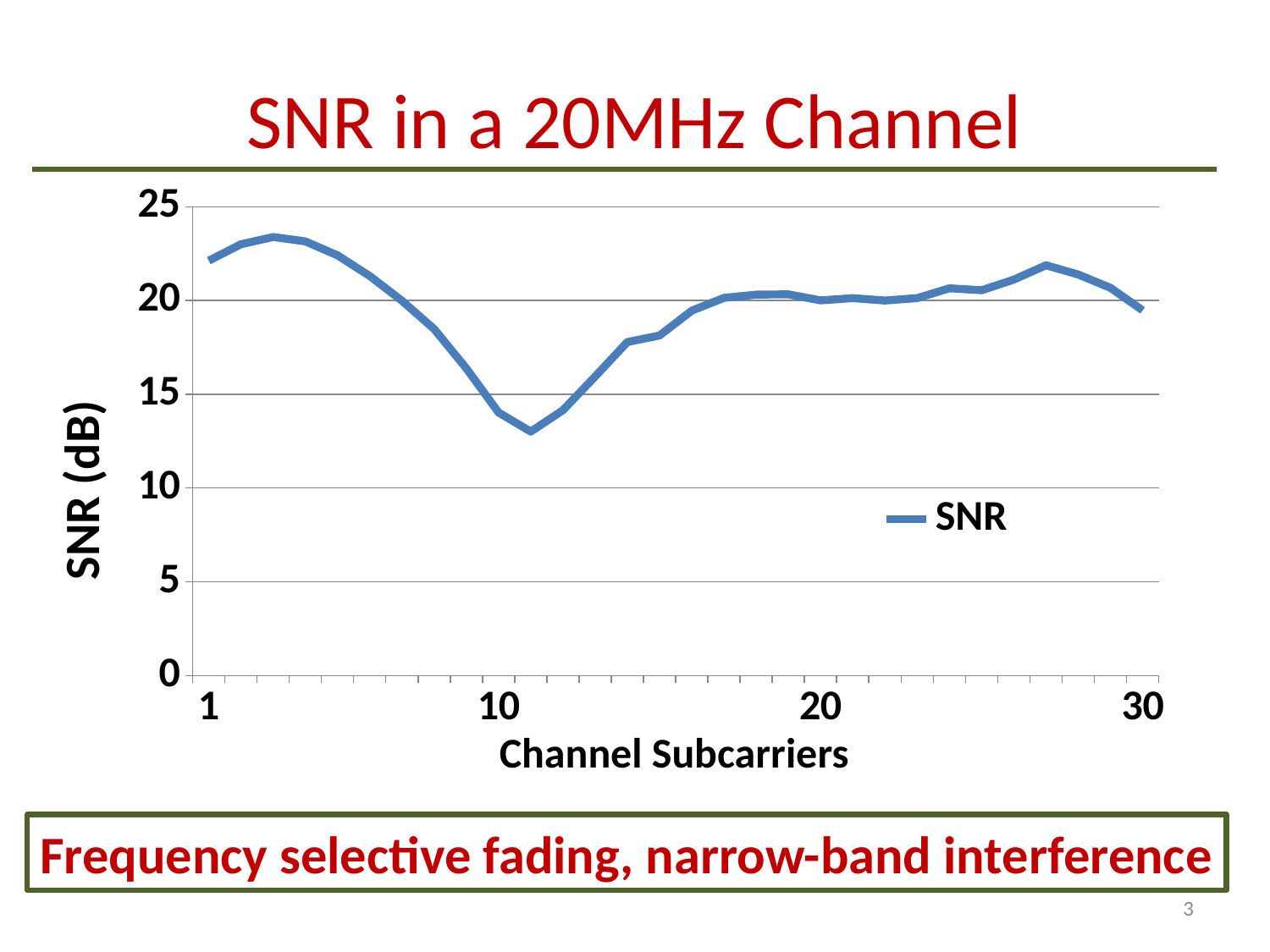
Is the SNR value at channel subcarrier 10 greater or less than 15? less How many series does the legend list? 1 What is the title of the chart? SNR in a 20MHz Channel Is the SNR value at channel subcarrier 1 greater or less than 20? greater Which has the higher SNR value, channel subcarrier 1 or channel subcarrier 20? 1 Does the SNR line rise or fall between channel subcarrier 1 and channel subcarrier 10? fall What is the label of the vertical axis? SNR (dB) Is the SNR value at channel subcarrier 20 greater or less than 15? greater Which has the higher SNR value, channel subcarrier 1 or channel subcarrier 10? 1 What kind of chart is shown on the slide? line chart